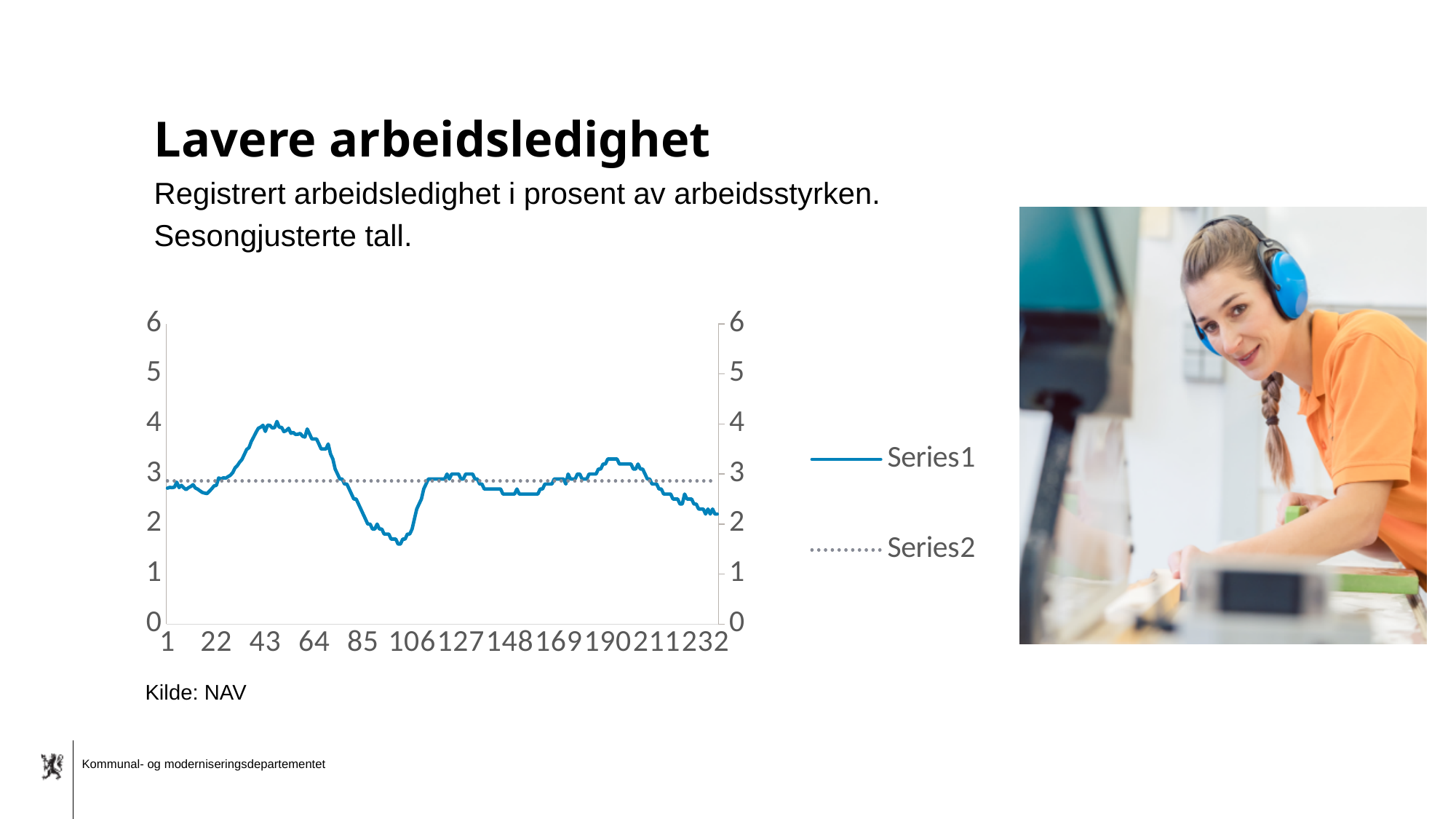
What are the names of the two series in the legend? Series1 and Series2 What is the highest value shown on the vertical axis? 6 Which series reaches the highest value on the chart? Series1 Which series is drawn as a dotted line? Series2 Is the value of Series1 at x = 43 greater or less than 3? greater Is the value of Series1 at x = 232 greater or less than 3? less What kind of chart is shown on the slide? Line chart How many series does the chart legend list? 2 Is the value of Series2 greater or less than 2 across the chart? greater At x = 43, which series has the larger value, Series1 or Series2? Series1 Does Series1 end at x = 232 higher or lower than it starts at x = 1? Lower